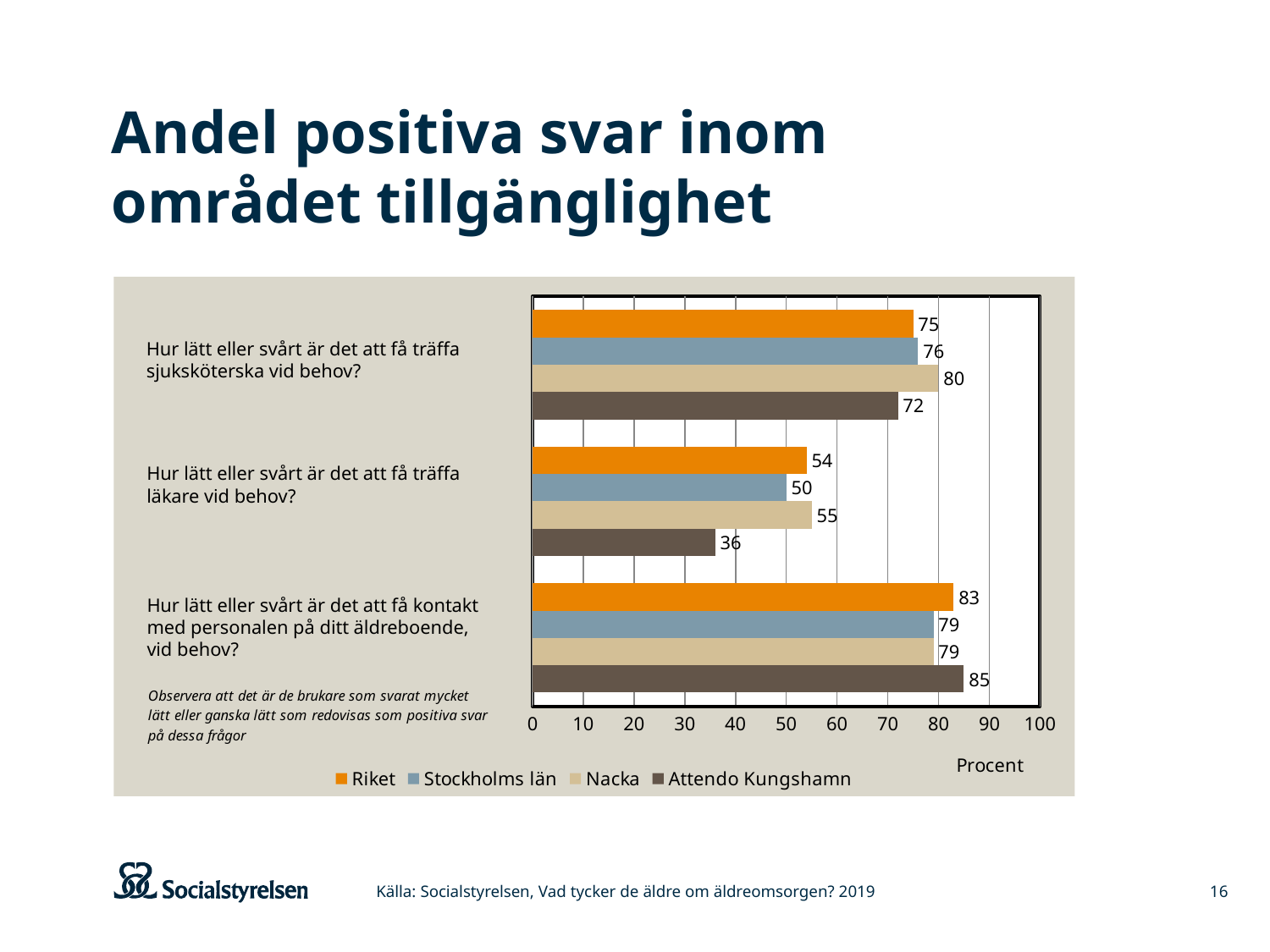
What is the value for Riket on the question "Hur lätt eller svårt är det att få kontakt med personalen på ditt äldreboende, vid behov?"? 83 What is the value for Attendo Kungshamn on the question "Hur lätt eller svårt är det att få träffa läkare vid behov?"? 36 Is the value for Stockholms län on the question "Hur lätt eller svårt är det att få träffa läkare vid behov?" greater or less than 60? less How many question categories are plotted on the chart? 3 How many series does the legend list? 4 On the question "Hur lätt eller svårt är det att få träffa sjuksköterska vid behov?", which is larger: Riket or Attendo Kungshamn? Riket What is the difference between Nacka and Attendo Kungshamn on the question "Hur lätt eller svårt är det att få träffa läkare vid behov?"? 19 What kind of chart is shown on the slide? Bar chart What unit is shown on the horizontal axis of the chart? Procent Which series has the highest value on the question "Hur lätt eller svårt är det att få kontakt med personalen på ditt äldreboende, vid behov?"? Attendo Kungshamn What is the value for Nacka on the question "Hur lätt eller svårt är det att få träffa sjuksköterska vid behov?"? 80 Which series has the lowest value on the question "Hur lätt eller svårt är det att få träffa läkare vid behov?"? Attendo Kungshamn